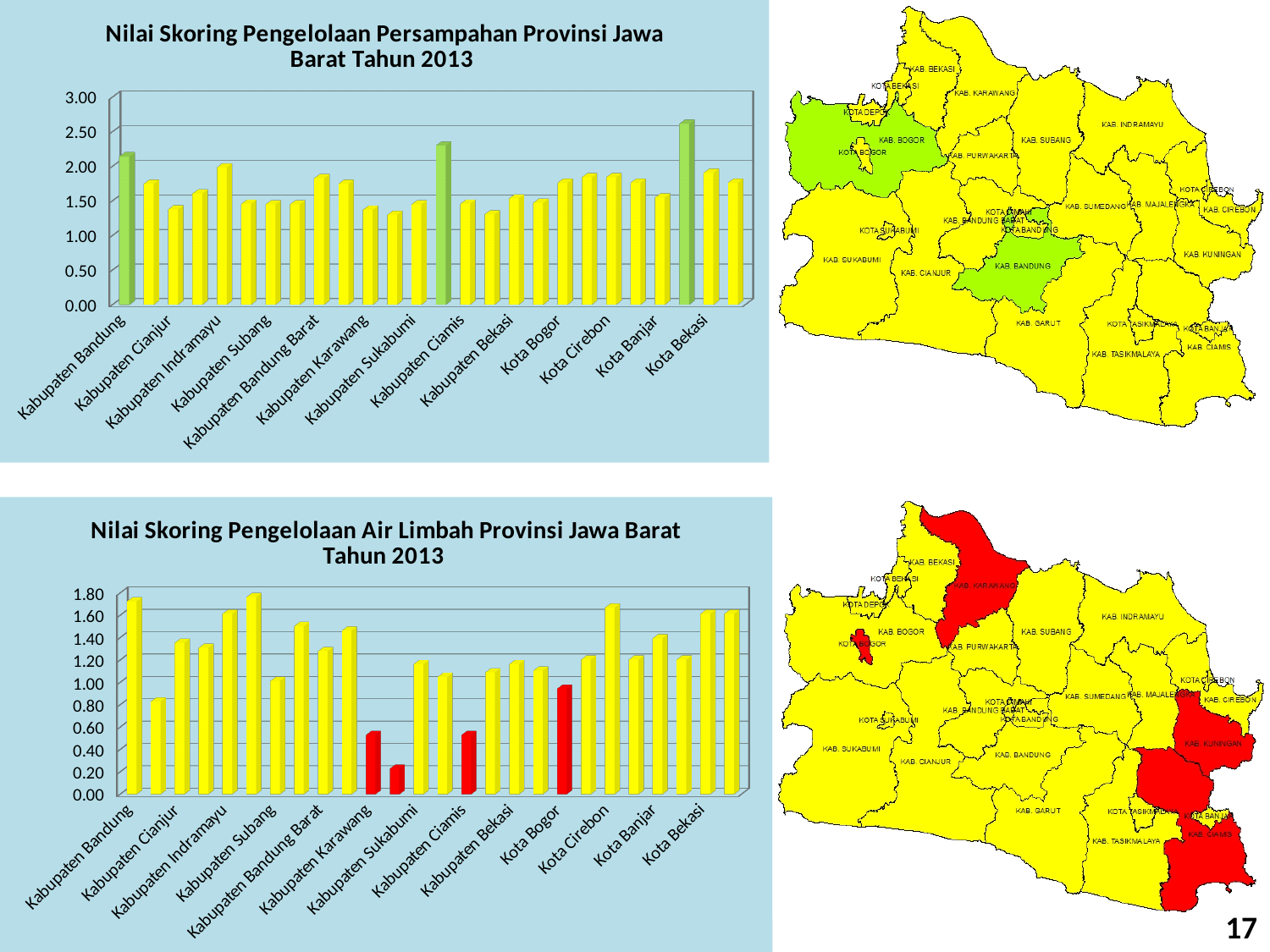
In the bottom chart (Pengelolaan Air Limbah), which is larger, the value for Kota Cirebon or the value for Kabupaten Cianjur? Kota Cirebon In the top chart (Pengelolaan Persampahan), is the value for Kabupaten Sukabumi greater or less than 2.00? less In the top chart (Pengelolaan Persampahan), is the value for Kabupaten Bandung greater or less than 1.50? greater In the bottom chart (Pengelolaan Air Limbah), which is larger, the value for Kabupaten Bandung or the value for Kabupaten Karawang? Kabupaten Bandung In the bottom chart (Pengelolaan Air Limbah), is the value for Kabupaten Bandung greater or less than 1.00? greater What is the title of the bottom chart? Nilai Skoring Pengelolaan Air Limbah Provinsi Jawa Barat Tahun 2013 In the top chart (Pengelolaan Persampahan), which is larger, the value for Kabupaten Bandung or the value for Kabupaten Cianjur? Kabupaten Bandung In the bottom chart (Pengelolaan Air Limbah), what colour are the highlighted bars such as Kabupaten Karawang and Kabupaten Ciamis? red What kind of chart is the top chart, 'Nilai Skoring Pengelolaan Persampahan Provinsi Jawa Barat Tahun 2013'? bar chart